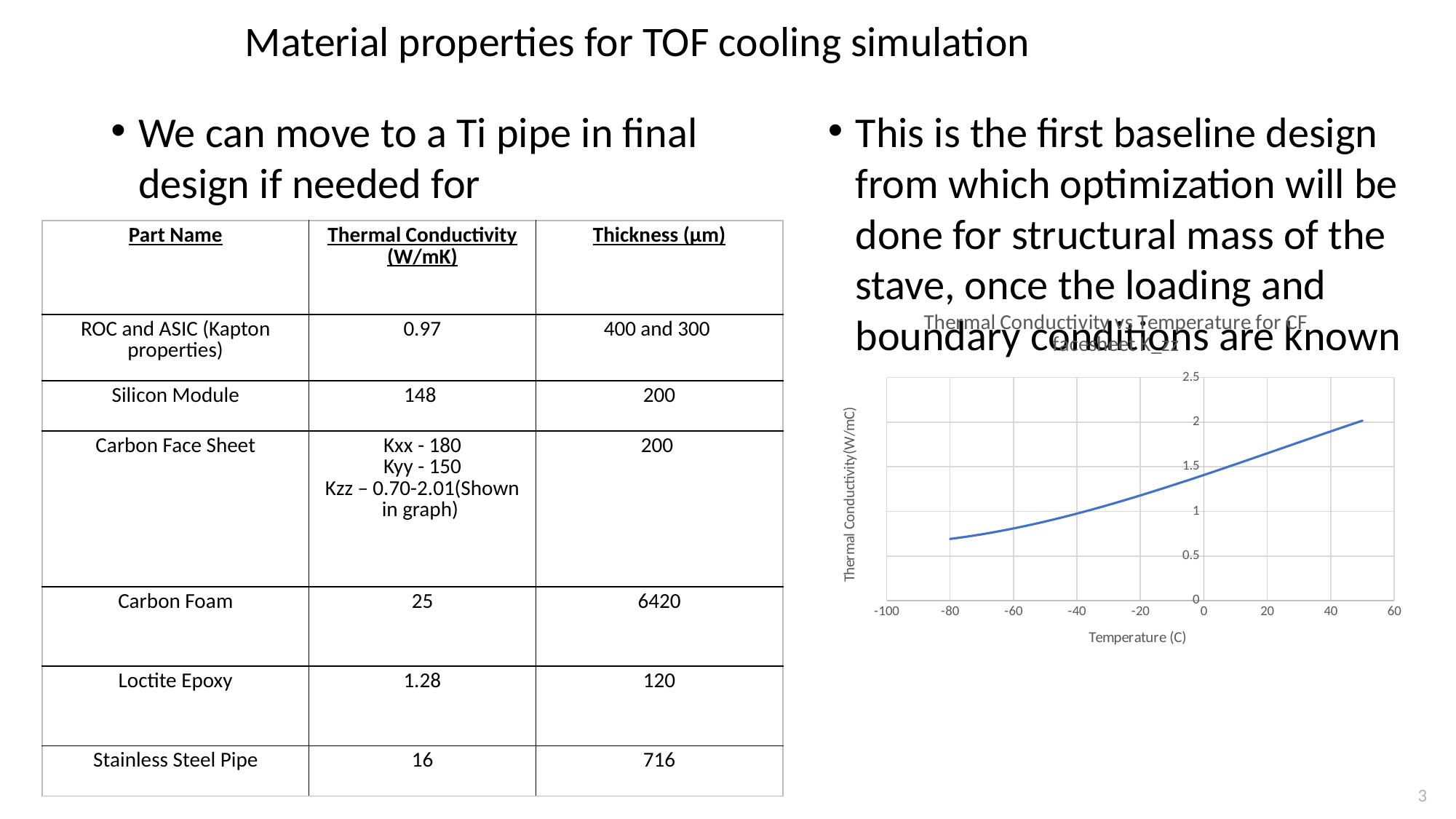
What kind of chart is shown on the right of the slide? line chart What is the x-axis label of the chart on the slide? Temperature (C) In the Thermal Conductivity vs Temperature chart, does thermal conductivity rise or fall as temperature increases? rise What is the y-axis label of the chart on the slide? Thermal Conductivity(W/mC) In the Thermal Conductivity vs Temperature chart, is the thermal conductivity higher at 40 C or at -80 C? 40 C In the Thermal Conductivity vs Temperature chart, is the thermal conductivity at 40 C greater or less than 2? less In the Thermal Conductivity vs Temperature chart, is the thermal conductivity at -60 C greater or less than 1? less In the Thermal Conductivity vs Temperature chart, is the thermal conductivity at -80 C greater or less than 1? less How many lines are plotted in the Thermal Conductivity vs Temperature chart? 1